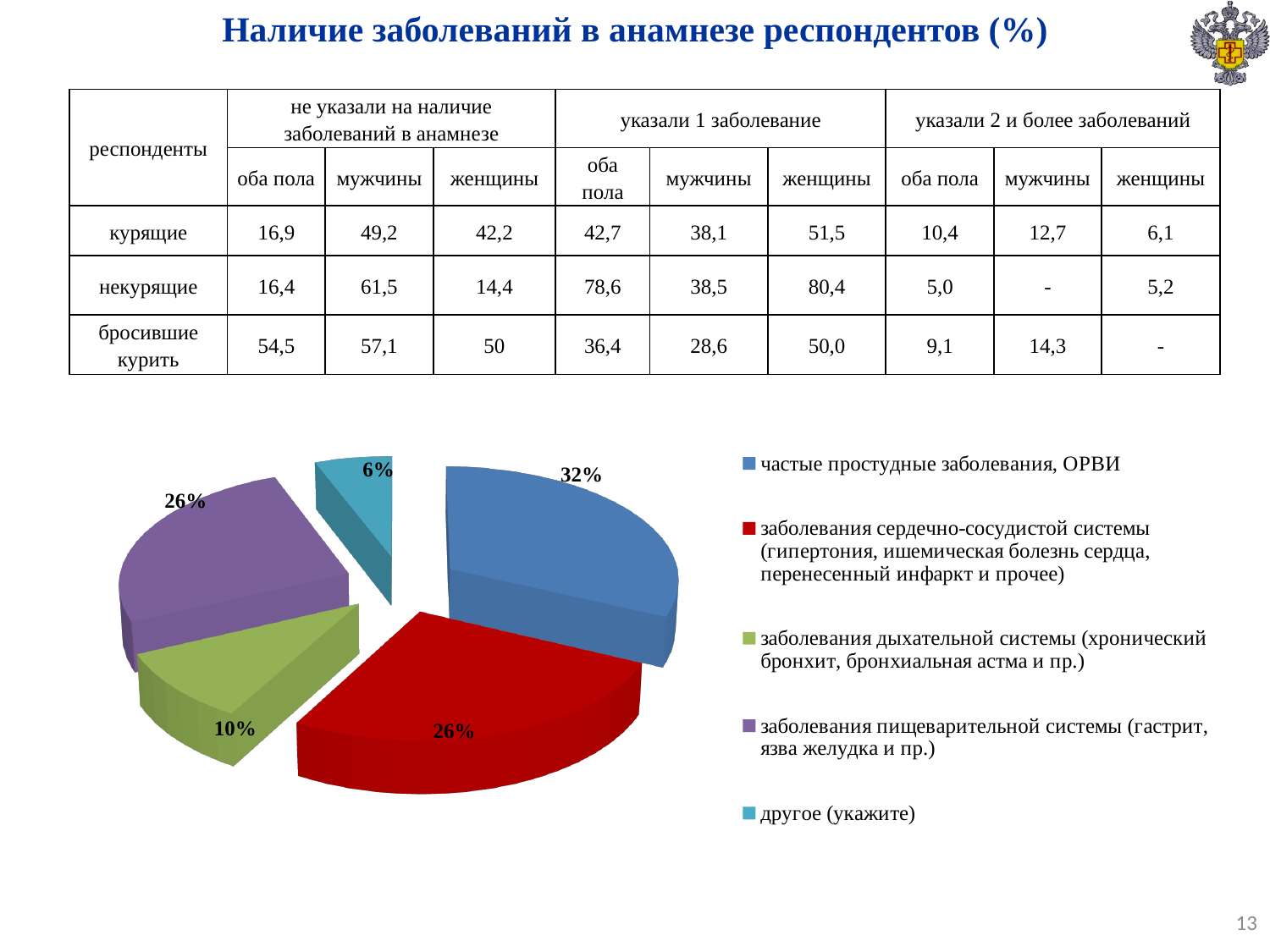
What colour is the slice for 'заболевания сердечно-сосудистой системы' in the pie chart? red How many slices does the pie chart have? 5 What share of the pie chart is 'заболевания дыхательной системы (хронический бронхит, бронхиальная астма и пр.)'? 10% What share of the pie chart is 'другое (укажите)'? 6% What share of the pie chart is 'заболевания сердечно-сосудистой системы'? 26% Which is larger in the pie chart: 'частые простудные заболевания, ОРВИ' or 'заболевания дыхательной системы'? частые простудные заболевания, ОРВИ Which category has the smallest slice in the pie chart? другое (укажите) Which category has the largest slice in the pie chart? частые простудные заболевания, ОРВИ How many entries does the pie chart legend list? 5 What kind of chart is shown on the slide? pie chart What is the difference in percentage points between the largest slice (ОРВИ) and the smallest slice (другое)? 26